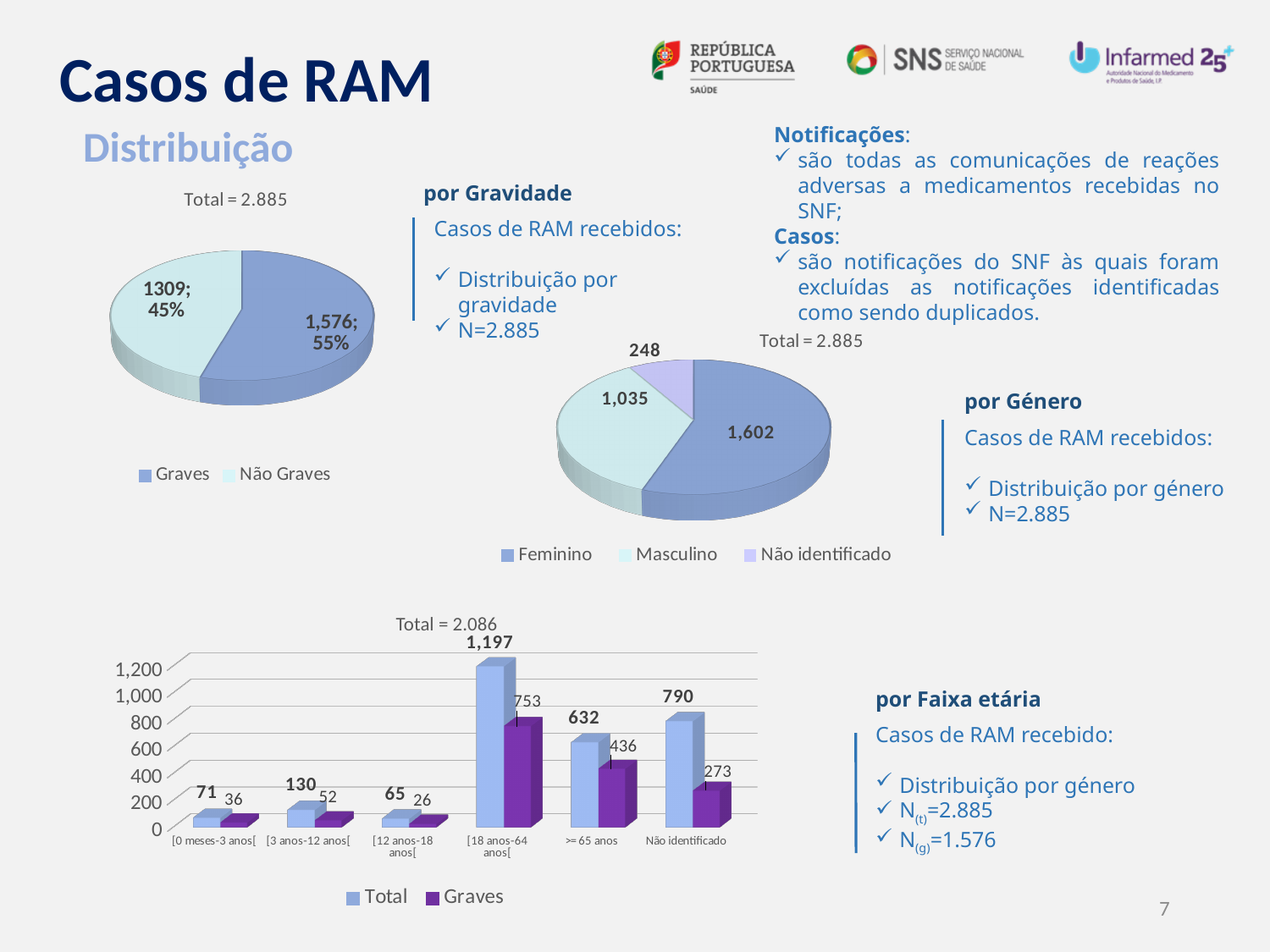
In the middle pie chart (por Género), which category has the smallest value? Não identificado In the bar chart at the bottom (por Faixa etária), which age category has the lowest Total value? [12 anos-18 anos[ In the bar chart at the bottom (por Faixa etária), how many series does the legend list? 2 In the pie chart on the left (por Gravidade), which slice is larger, Graves or Não Graves? Graves In the middle pie chart (por Género), how many categories does the legend list? 3 In the bar chart at the bottom (por Faixa etária), what is the Graves value for the >= 65 anos category? 436 What type of chart is the chart at the bottom of the slide (por Faixa etária)? Bar chart In the middle pie chart (por Género), what is the difference between the Feminino and Masculino values? 567 In the middle pie chart (por Género), what value is shown for Masculino? 1,035 In the pie chart on the left (por Gravidade), what value is shown for Graves? 1,576 In the bar chart at the bottom (por Faixa etária), what is the Total value for the [18 anos-64 anos[ category? 1,197 In the pie chart on the left (por Gravidade), what percentage share does Não Graves have? 45%